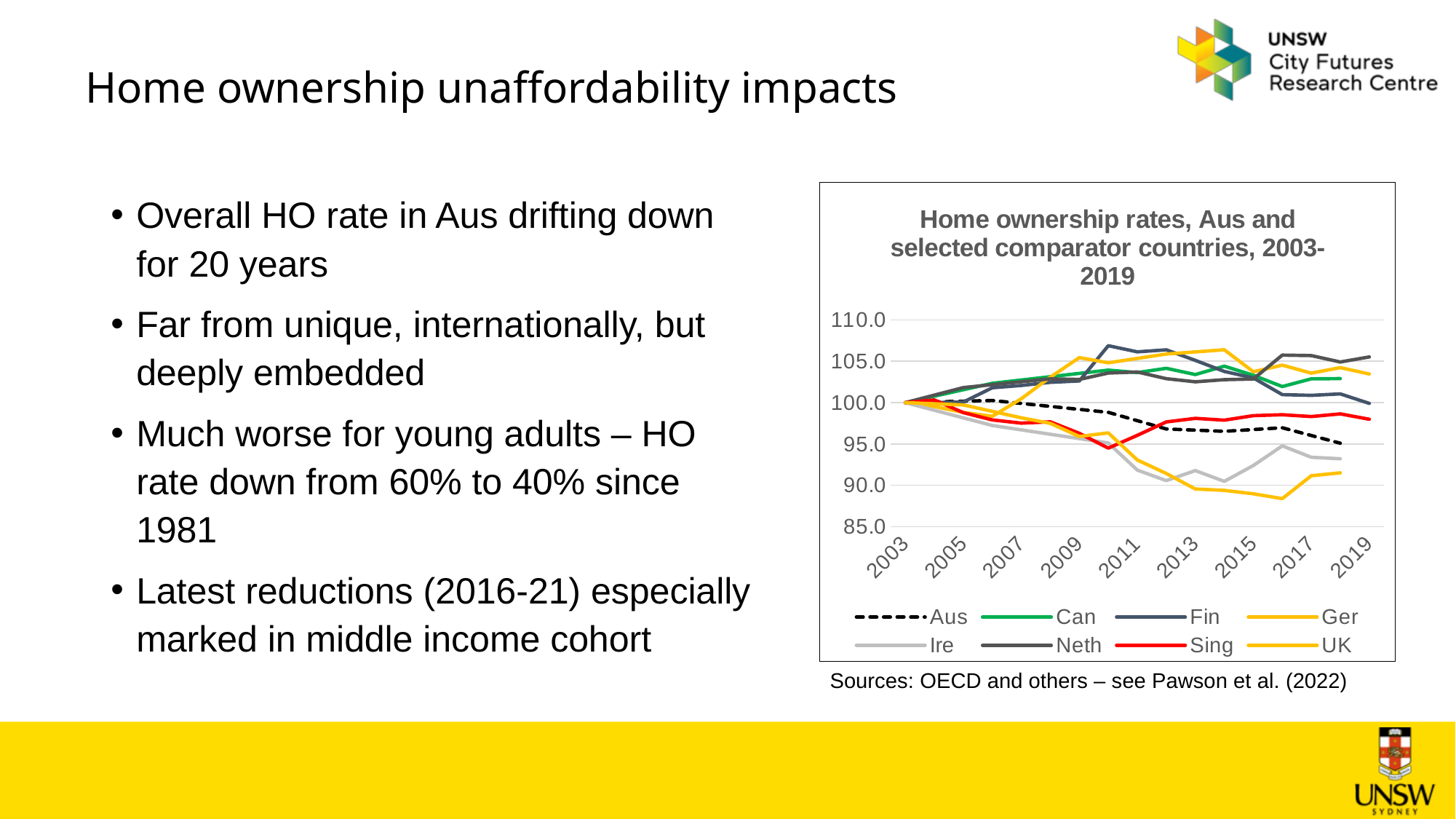
How many series does the chart legend list? 8 What kind of chart is shown on the slide? line chart Which series reaches the lowest point anywhere on the chart? UK How many year labels are shown on the x axis? 9 What is the value for Aus in 2003? 100.0 Which series has the highest value in 2019? Neth Does the Aus line rise or fall between 2003 and 2019? fall Which series is drawn with a dashed line? Aus